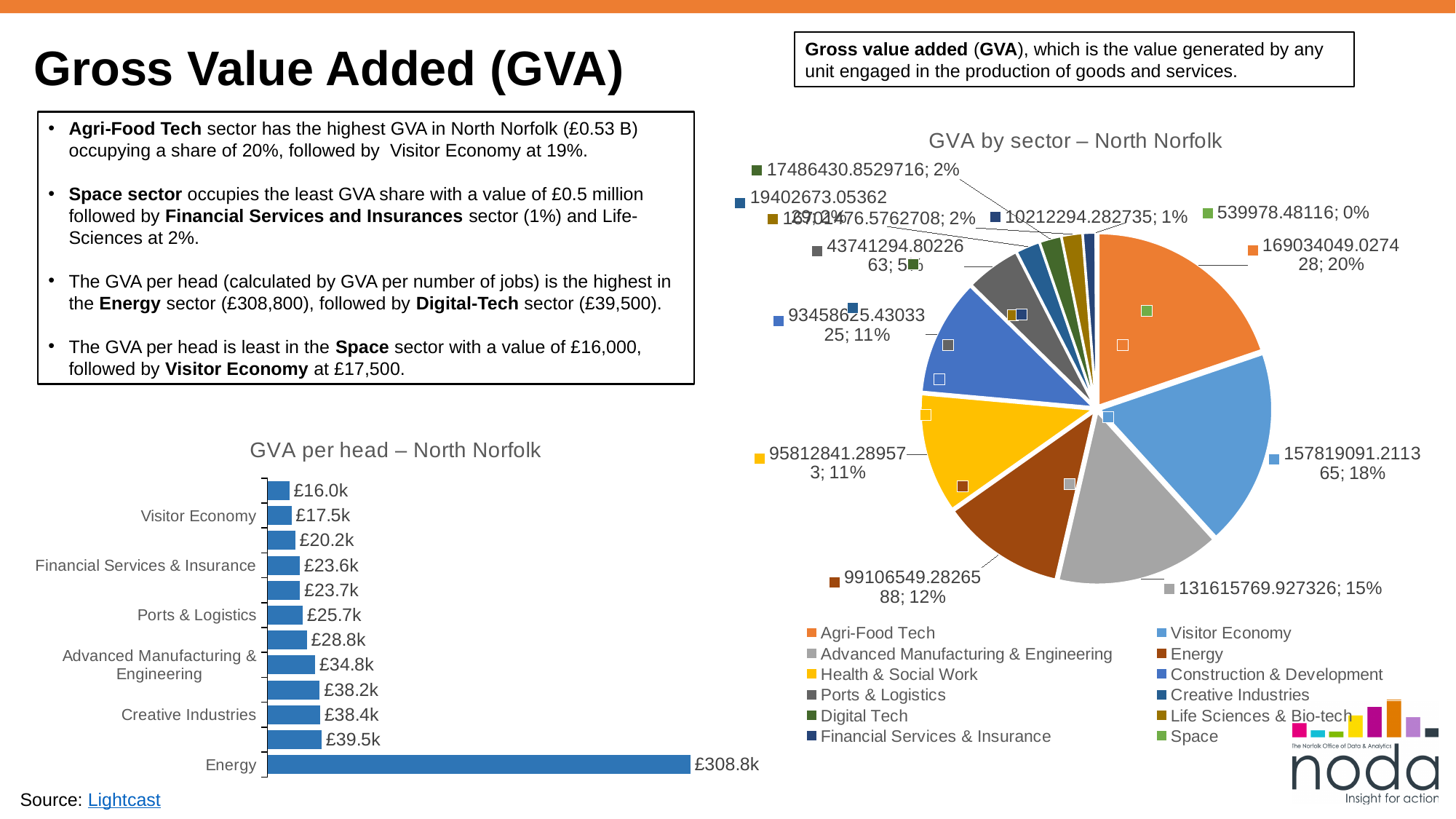
What kind of chart is 'GVA per head – North Norfolk'? Bar chart In the 'GVA by sector – North Norfolk' pie chart, what share does Agri-Food Tech have? 20% In the 'GVA per head – North Norfolk' chart, what is the value for Visitor Economy? £17.5k How many sectors does the legend of the 'GVA by sector – North Norfolk' chart list? 12 In the 'GVA per head – North Norfolk' chart, which sector has the highest GVA per head? Energy How many bars are plotted in the 'GVA per head – North Norfolk' chart? 12 In the 'GVA per head – North Norfolk' chart, what is the value for Ports & Logistics? £25.7k In the 'GVA per head – North Norfolk' chart, what is the GVA per head for Energy? £308.8k What kind of chart is 'GVA by sector – North Norfolk'? Pie chart In the 'GVA by sector – North Norfolk' pie chart, what share does Advanced Manufacturing & Engineering have? 15% In the 'GVA per head – North Norfolk' chart, which is larger: Advanced Manufacturing & Engineering or Ports & Logistics? Advanced Manufacturing & Engineering In the 'GVA per head – North Norfolk' chart, what is the difference between Creative Industries and Financial Services & Insurance? £14.8k